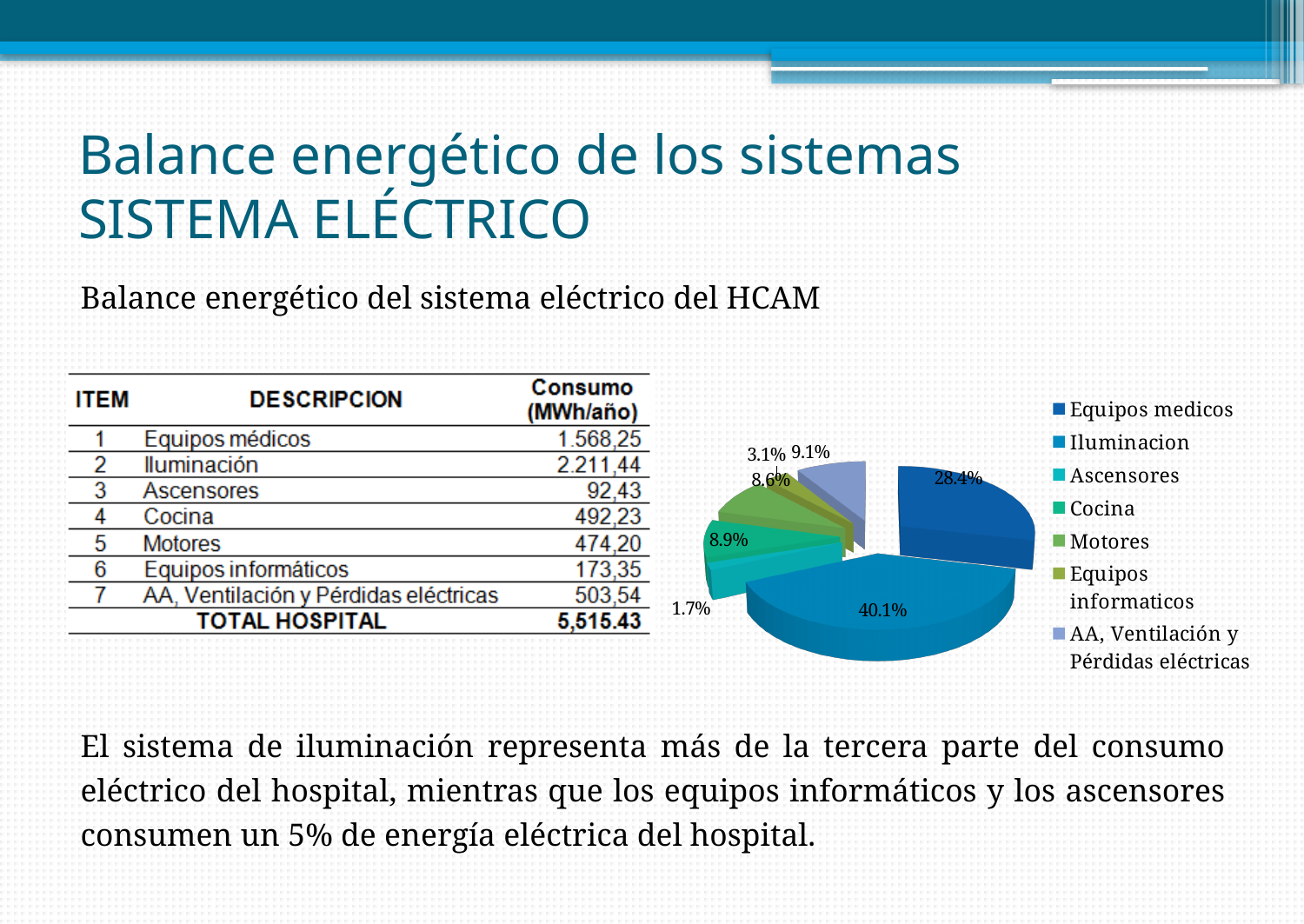
What percentage of the pie chart does AA, Ventilación y Pérdidas eléctricas represent? 9.1% What is the share of the pie taken by Equipos informaticos? 3.1% Which category has the smallest slice in the pie chart? Ascensores Which slice is larger in the pie chart, Equipos medicos or AA, Ventilación y Pérdidas eléctricas? Equipos medicos What percentage of the pie chart does Equipos medicos represent? 28.4% What percentage of the pie chart does Ascensores represent? 1.7% What is the difference in percentage points between the Iluminacion slice and the Equipos medicos slice? 11.7 What percentage of the pie chart does Iluminacion represent? 40.1% How many entries does the pie chart's legend list? 7 Which category has the largest slice in the pie chart? Iluminacion What kind of chart is shown on the slide? pie chart How many slices does the pie chart have? 7